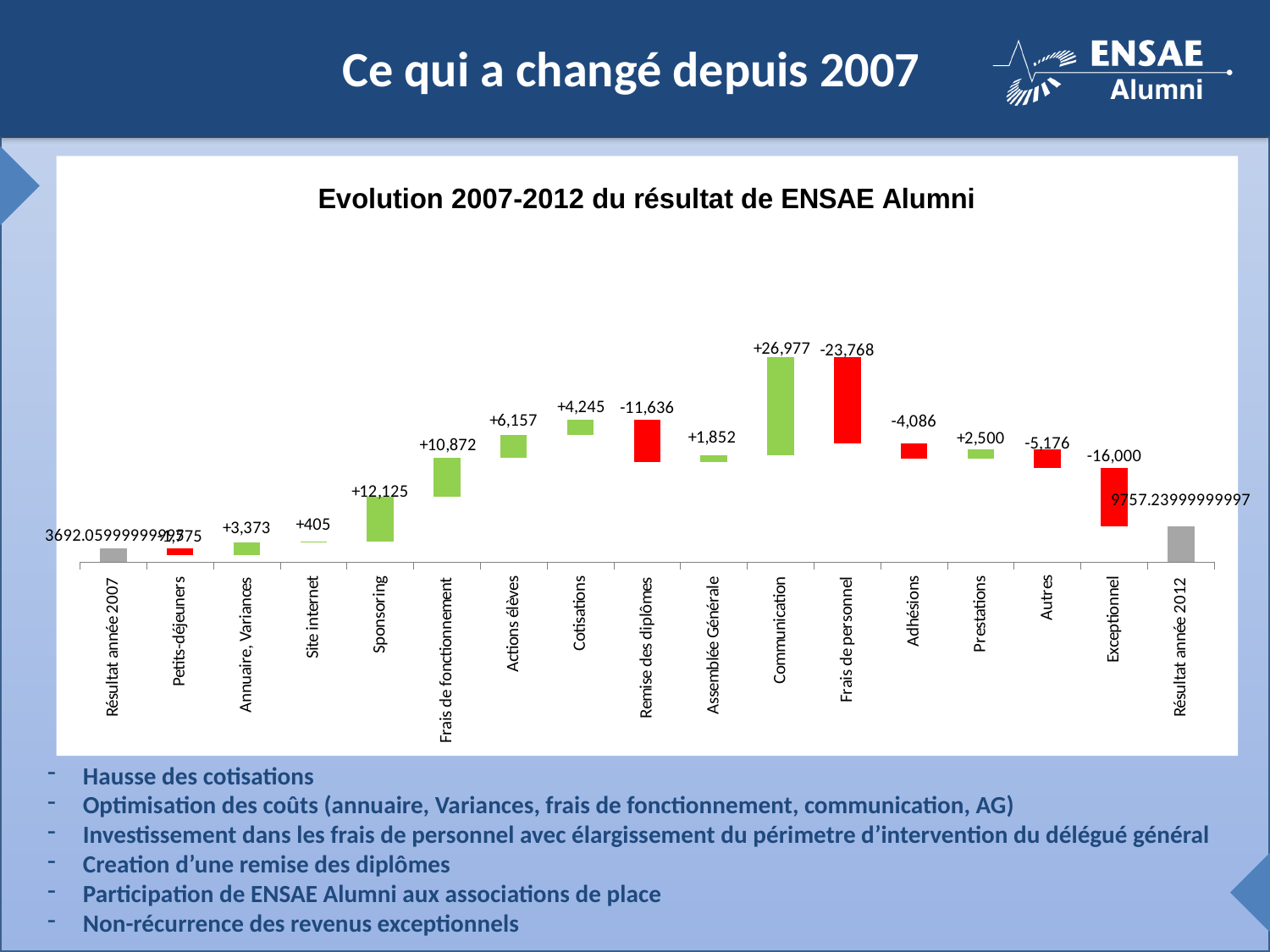
What is the value shown for Communication? +26,977 What is the value shown for Site internet? +405 What is the value shown for Exceptionnel? -16,000 Which category has the most negative value? Frais de personnel Which is larger, the value for Actions élèves or the value for Cotisations? Actions élèves Which category has the largest positive value? Communication What is the difference between the values for Sponsoring and Frais de fonctionnement? 1,253 What is the value shown for Frais de personnel? -23,768 What is the title of the chart? Evolution 2007-2012 du résultat de ENSAE Alumni How many categories are shown on the x axis? 17 What is the value shown for Sponsoring? +12,125 What kind of chart is shown on the slide? bar chart